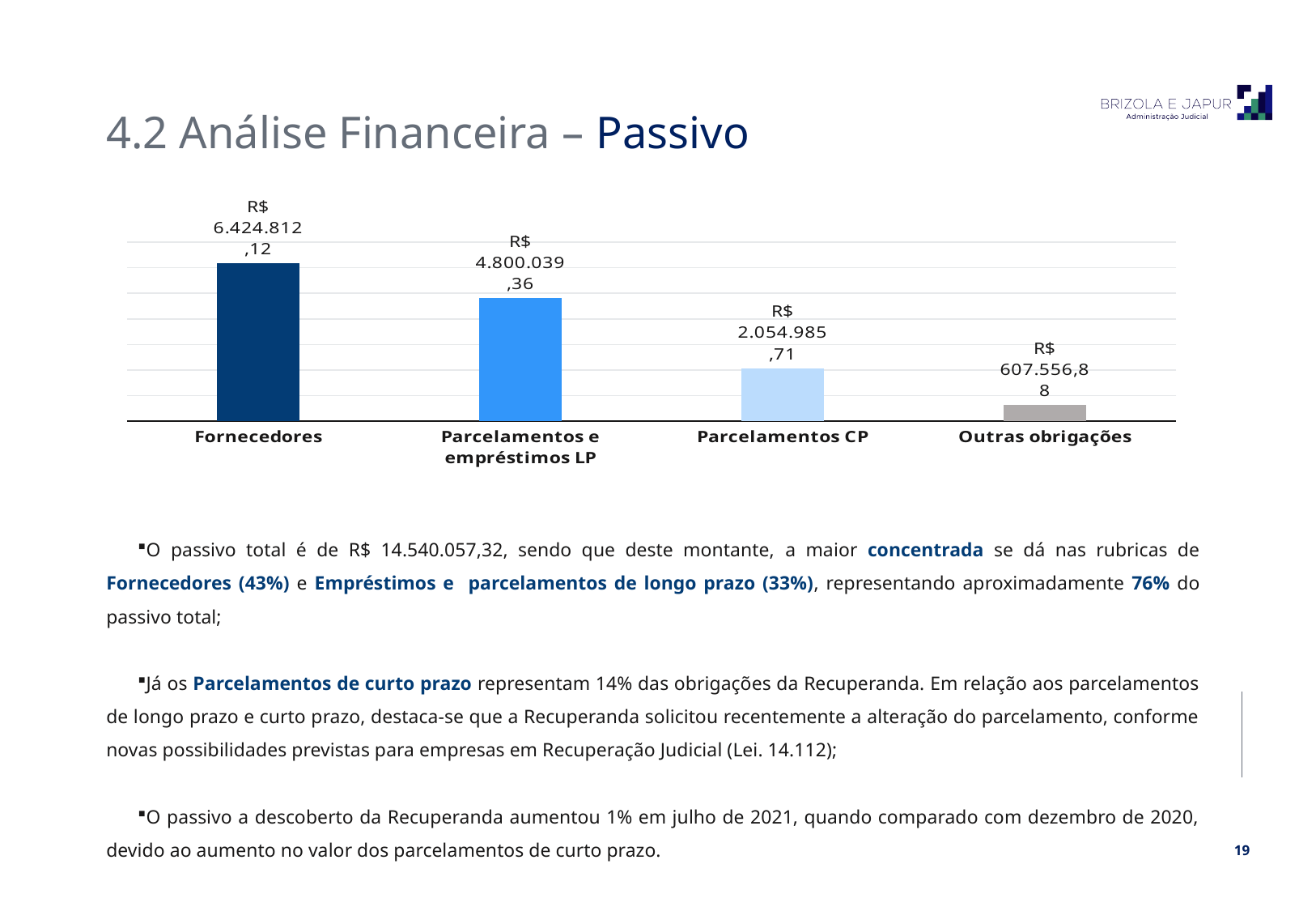
Which category has the lowest value? Outras obrigações How many categories are shown in the chart? 4 Do the values rise or fall from left to right across the categories? Fall Which is larger, the value for Parcelamentos CP or the value for Outras obrigações? Parcelamentos CP What is the value for Parcelamentos CP? R$ 2.054.985,71 What is the difference between the values for Parcelamentos CP and Outras obrigações? R$ 1.447.428,83 What is the value for Fornecedores? R$ 6.424.812,12 What is the difference between the values for Fornecedores and Parcelamentos e empréstimos LP? R$ 1.624.772,76 Which category has the highest value? Fornecedores What is the value for Outras obrigações? R$ 607.556,88 What type of chart is shown on the slide? Bar chart What is the value for Parcelamentos e empréstimos LP? R$ 4.800.039,36